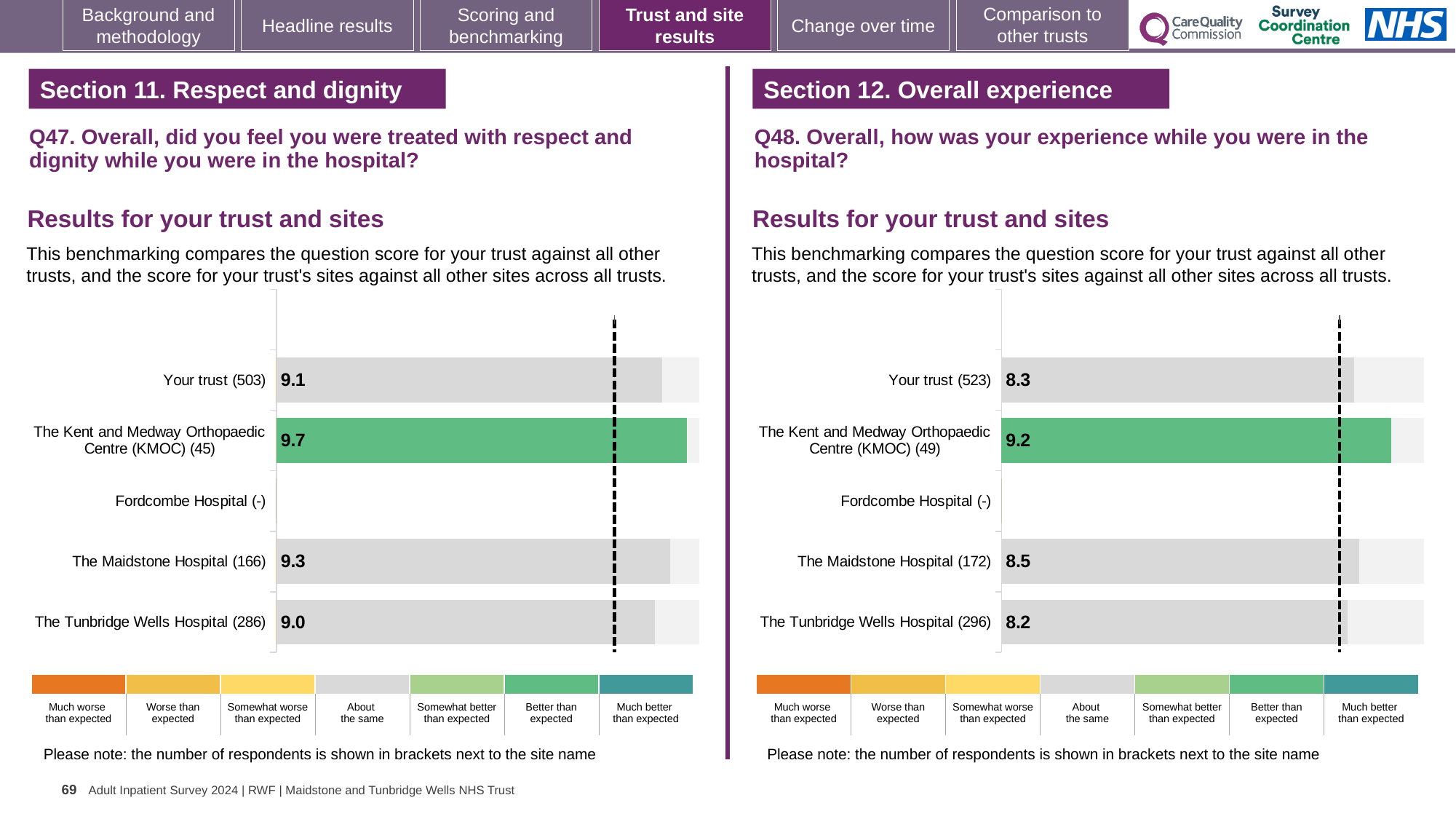
In the Q47 chart on the left, which site has the lowest score? The Tunbridge Wells Hospital How many sites or categories are listed in the Q47 chart on the left? 5 In the Q47 chart on the left, which benchmark category does the green colour of the KMOC bar represent according to the legend? Better than expected In the Q48 chart on the right, which has the larger score, Your trust or The Maidstone Hospital? The Maidstone Hospital In the Q48 chart on the right, what is the difference between the scores for The Kent and Medway Orthopaedic Centre (KMOC) and Your trust? 0.9 In the Q47 chart on the left, what is the score for Your trust? 9.1 In the Q48 chart on the right, what is the score for The Tunbridge Wells Hospital? 8.2 In the Q48 chart on the right, which site has the highest score? The Kent and Medway Orthopaedic Centre (KMOC) In the Q47 chart on the left, what is the score for The Kent and Medway Orthopaedic Centre (KMOC)? 9.7 In the Q48 chart on the right, what is the score for The Maidstone Hospital? 8.5 What kind of chart is used in the Q48 chart on the right? Bar chart In the Q47 chart on the left, what is the difference between the scores for The Maidstone Hospital and The Tunbridge Wells Hospital? 0.3